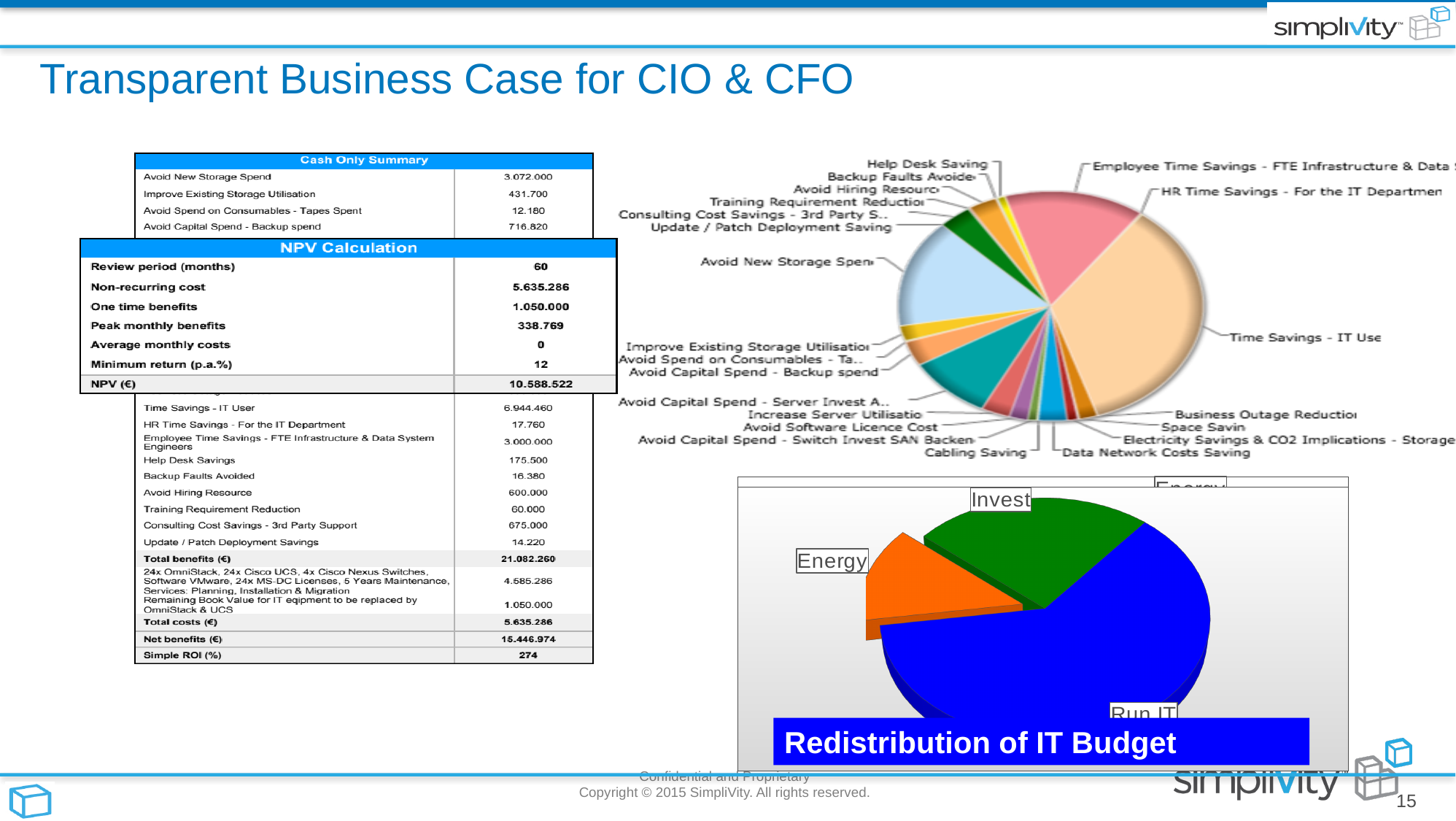
What kind of chart is the large chart at the top right of the slide? pie chart In the "Redistribution of IT Budget" chart, which slice is the smallest? Energy In the "Redistribution of IT Budget" chart, which slice is the largest? Run IT What kind of chart is the chart titled "Redistribution of IT Budget"? pie chart In the top-right pie chart, which slice is larger, Avoid New Storage Spend or Help Desk Saving? Avoid New Storage Spend In the "Redistribution of IT Budget" chart, which slice is larger, Invest or Energy? Invest In the top-right pie chart, which slice is the largest? Time Savings - IT User What is the title of the pie chart at the bottom right of the slide? Redistribution of IT Budget In the top-right pie chart, which slice is larger, Time Savings - IT User or HR Time Savings - For the IT Department? Time Savings - IT User In the "Redistribution of IT Budget" chart, what colour is the Run IT slice? blue